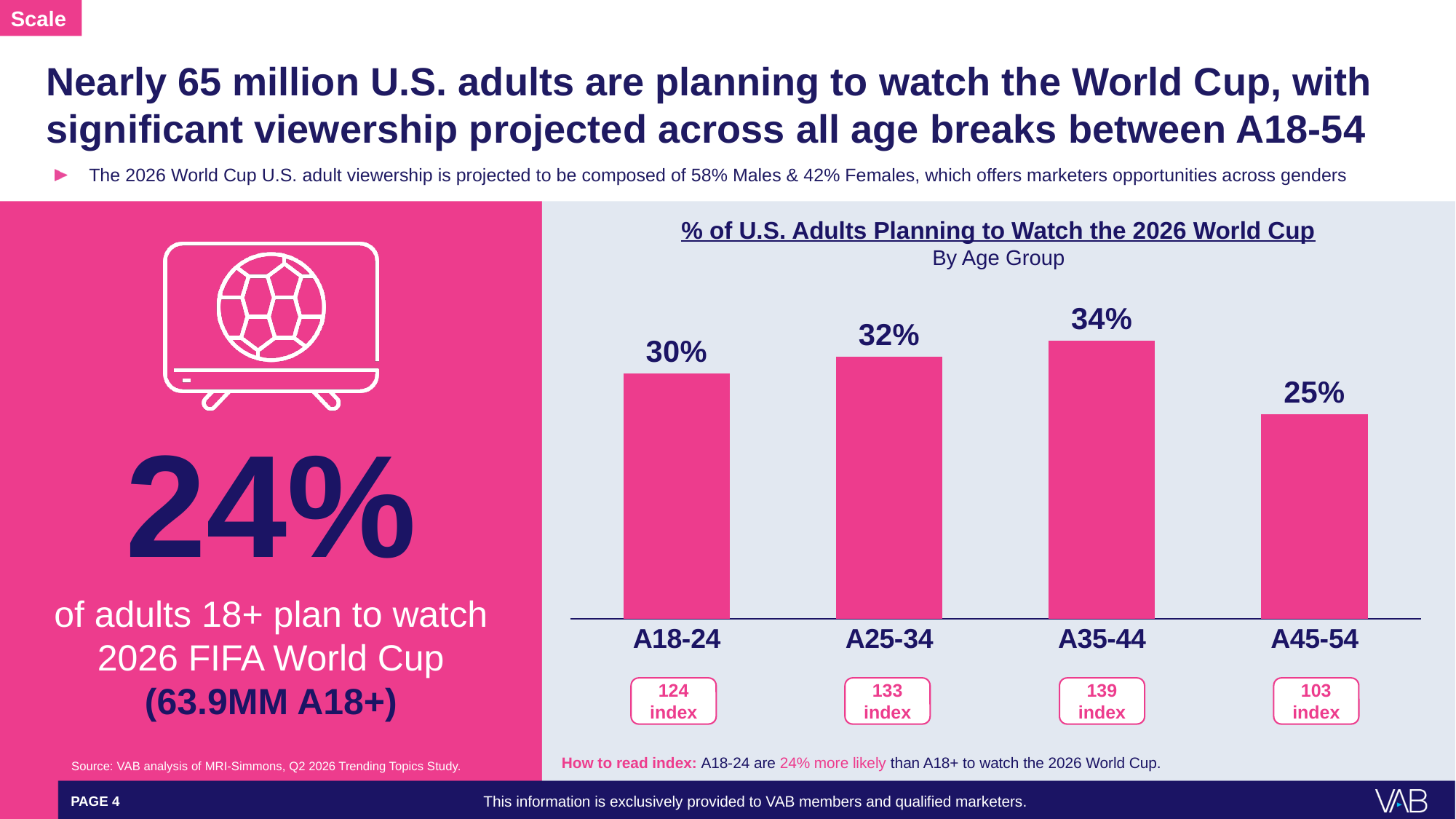
What kind of chart is used to show the % of U.S. adults planning to watch the 2026 World Cup by age group? Bar chart What percentage of A25-34 are planning to watch the 2026 World Cup? 32% What is the index value shown for A35-44? 139 Which age group has the lowest percentage planning to watch the 2026 World Cup? A45-54 What is the title of the chart? % of U.S. Adults Planning to Watch the 2026 World Cup Which age group has the highest percentage planning to watch the 2026 World Cup? A35-44 What percentage of A45-54 are planning to watch the 2026 World Cup? 25% What is the index value shown for A45-54? 103 How many age groups are shown in the chart? 4 Which age group has a higher percentage planning to watch, A18-24 or A25-34? A25-34 What is the difference in percentage points between A35-44 and A45-54? 9 What percentage of A18-24 are planning to watch the 2026 World Cup? 30%